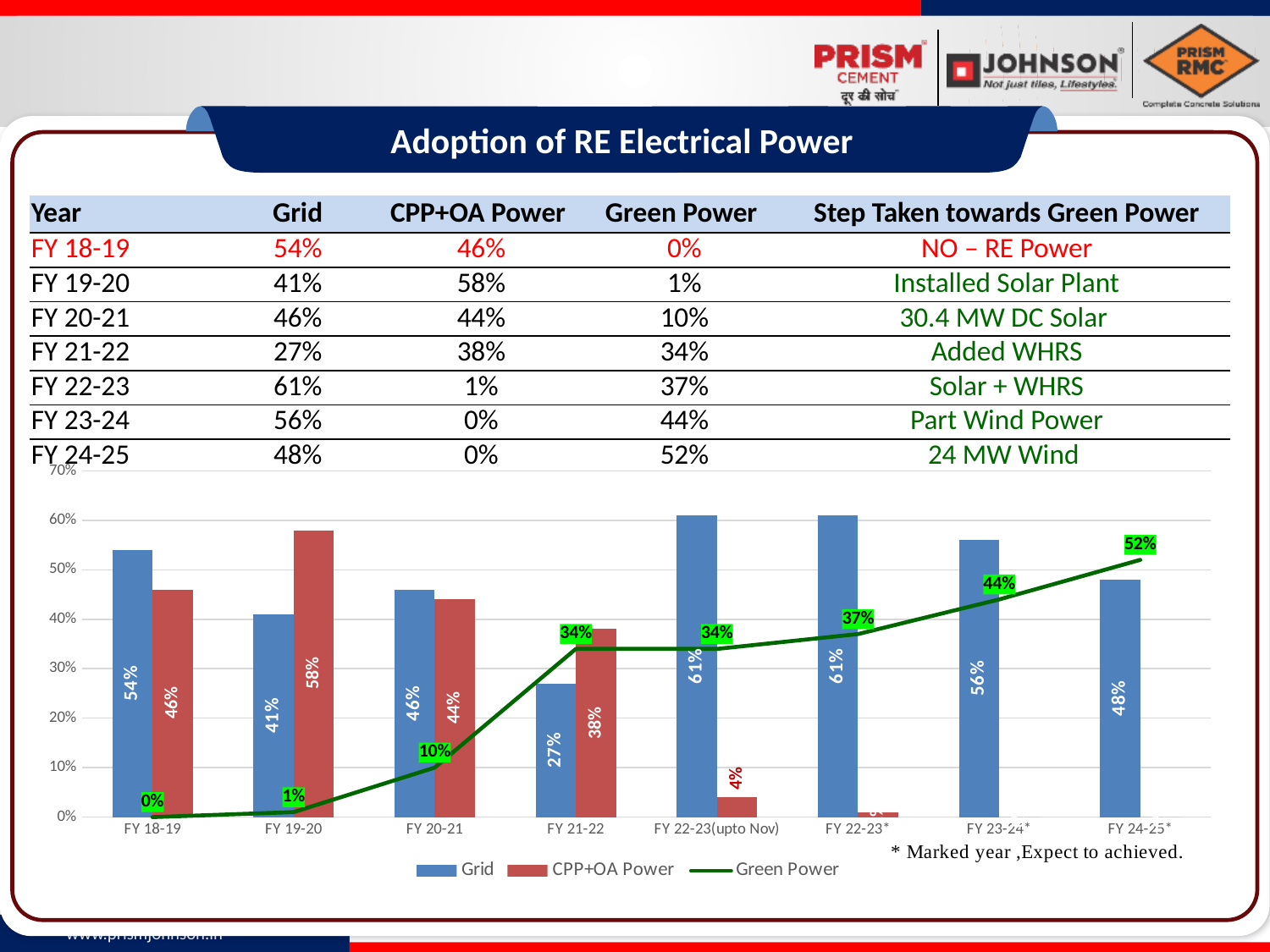
What is the CPP+OA Power value for FY 19-20 in the chart? 58% What is the Green Power value for FY 23-24* in the chart? 44% Which category has the highest Green Power value in the chart? FY 24-25* What is the Grid value for FY 21-22 in the chart? 27% How many categories are shown on the x axis of the chart? 8 What colour are the Grid bars in the chart? Blue What type of chart is shown on the slide? Combined bar and line chart How many series does the chart legend list? 3 Does the Green Power line rise or fall from FY 18-19 to FY 24-25*? Rise What is the difference between the Grid value and the CPP+OA Power value for FY 18-19? 8% Which is larger for FY 20-21: the Grid value or the CPP+OA Power value? Grid Which category has the lowest Grid value in the chart? FY 21-22